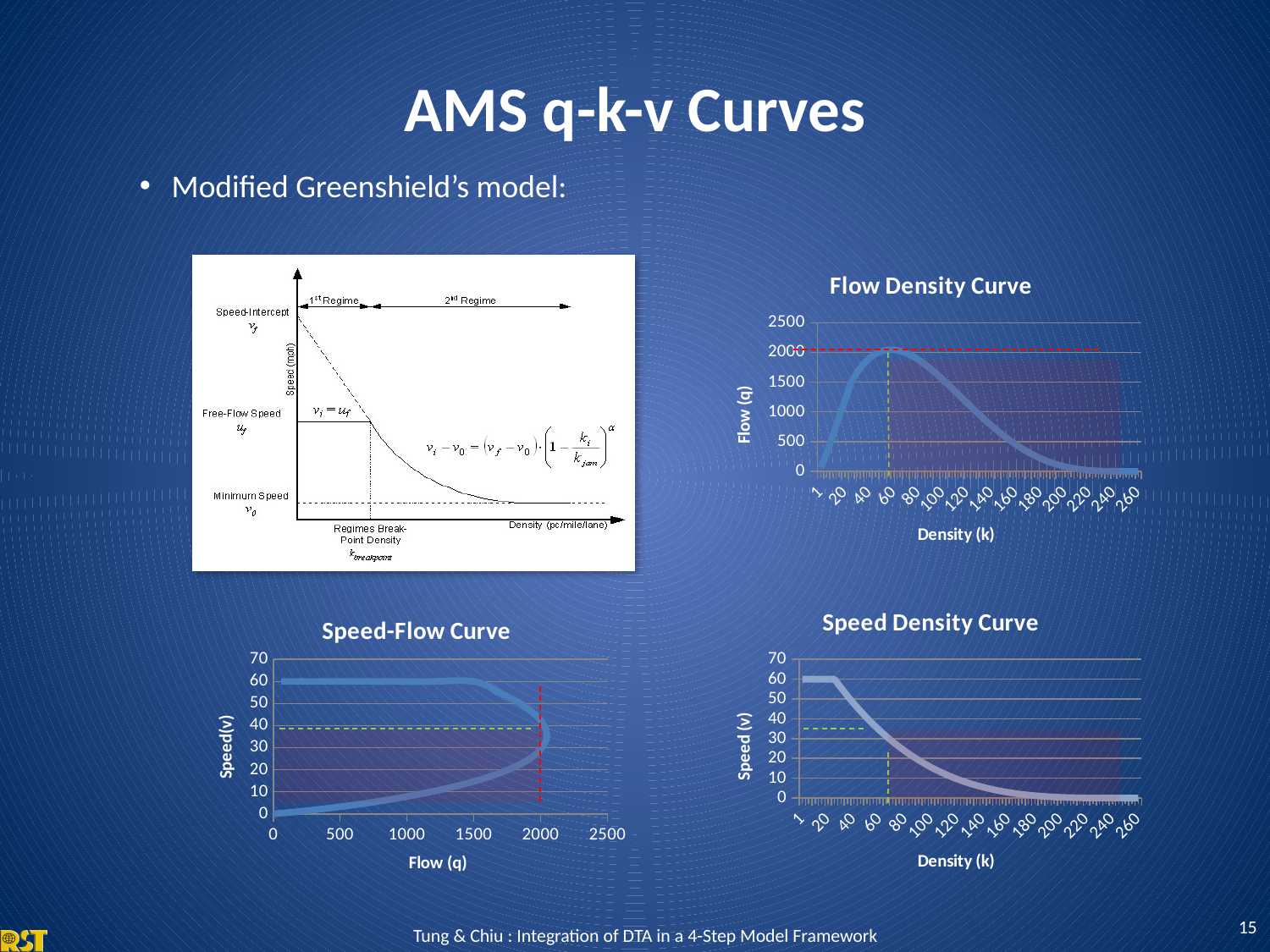
What kind of chart is the Flow Density Curve? line chart In the Flow Density Curve, is the flow at a density of 60 greater or less than 1500? greater In the Flow Density Curve, is the flow at a density of 200 greater or less than 500? less In the Flow Density Curve, does the flow rise or fall as density increases from 1 to 40? rise In the Speed Density Curve, is the speed at a density of 200 greater or less than 10? less In the Speed Density Curve, does the speed rise or fall as density increases from 40 to 160? fall In the Speed-Flow Curve, what is the label of the x axis? Flow (q) In the Flow Density Curve, does the flow rise or fall as density increases from 100 to 200? fall What kind of chart is the Speed-Flow Curve? line chart In the Flow Density Curve, what is the label of the y axis? Flow (q)